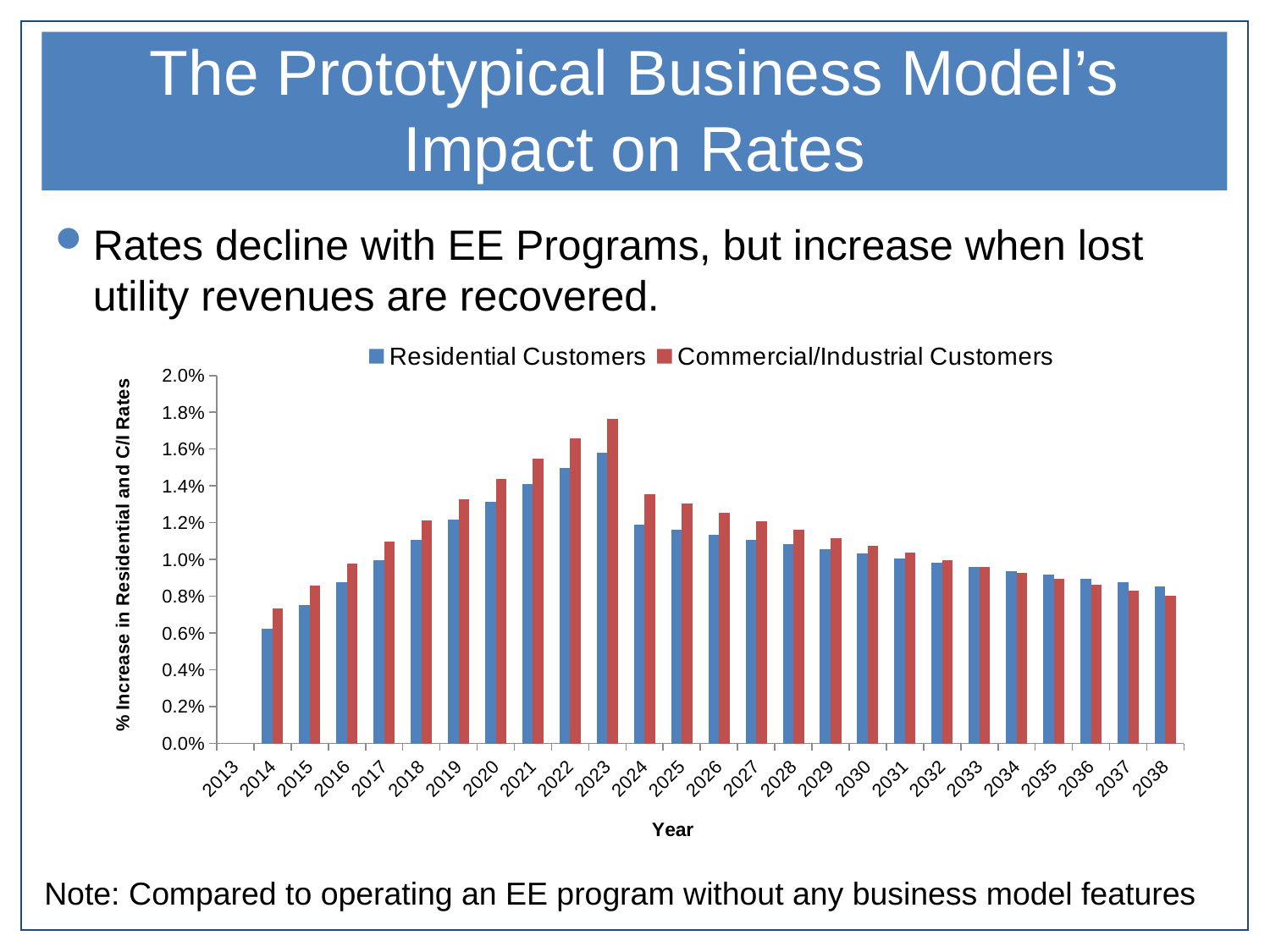
Is the Residential Customers value for 2014 greater or less than 0.8%? less How many series does the legend list? 2 In 2019, which series has the larger value, Residential Customers or Commercial/Industrial Customers? Commercial/Industrial Customers In which year is the Residential Customers value highest? 2023 What kind of chart is shown on the slide? bar chart Is the Commercial/Industrial Customers value for 2023 greater or less than 1.6%? greater Is the Residential Customers value for 2023 greater or less than 1.4%? greater Do the Residential Customers values rise or fall from 2023 to 2038? fall In which year is the Commercial/Industrial Customers value highest? 2023 What colour represents Residential Customers in the chart? blue In which year is the Residential Customers value lowest? 2013